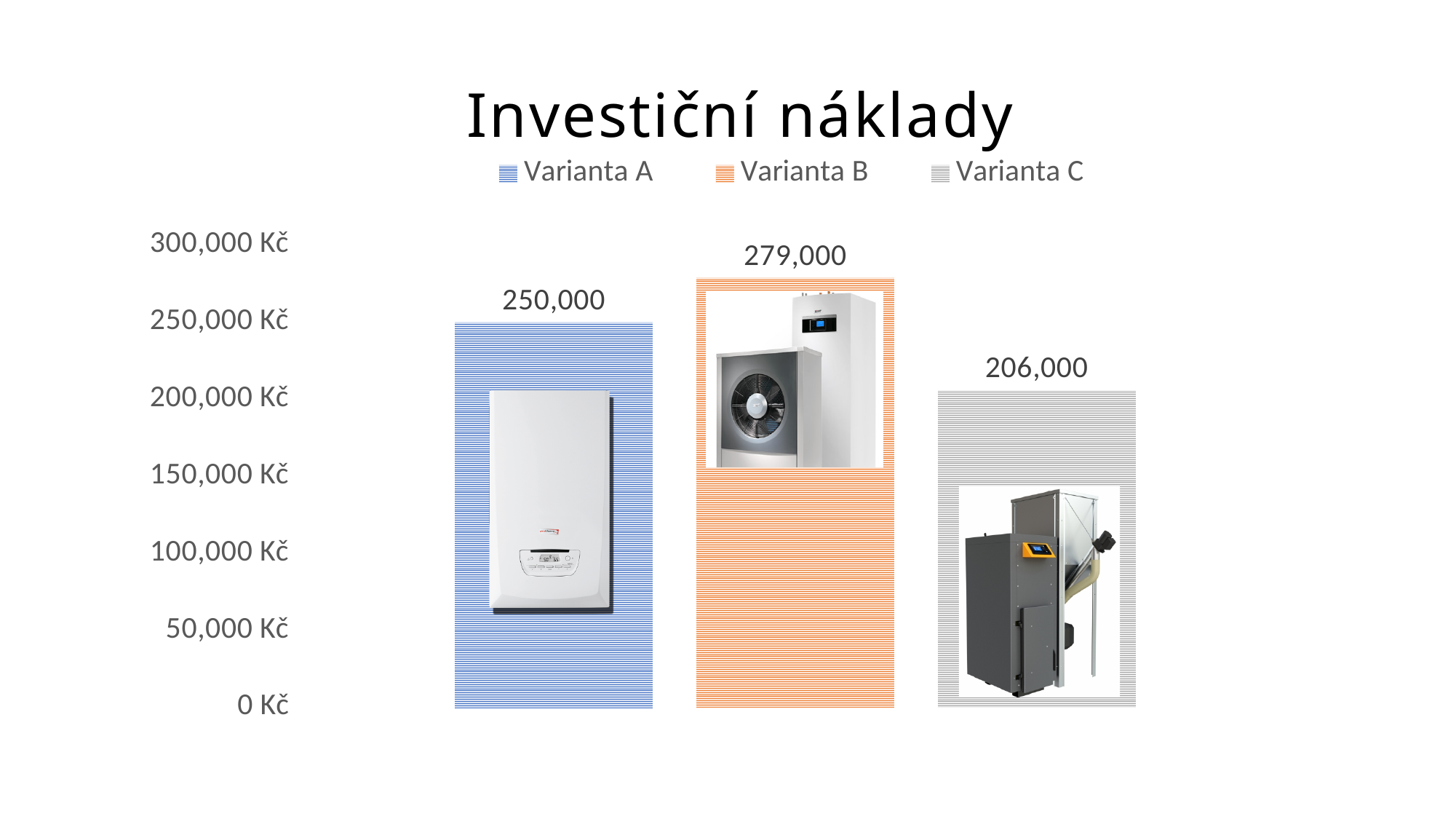
What is the value for Varianta A? 250,000 What kind of chart is shown on the slide? bar chart How many series does the legend list? 3 What is the value for Varianta C? 206,000 Is the value for Varianta C greater or less than 250,000 Kč? less What is the difference between the values for Varianta B and Varianta A? 29,000 Which is larger, the value for Varianta A or Varianta C? Varianta A Which variant has the highest investment cost? Varianta B Which variant has the lowest investment cost? Varianta C What is the difference between the values for Varianta A and Varianta C? 44,000 What is the title of the chart? Investiční náklady What is the value for Varianta B? 279,000